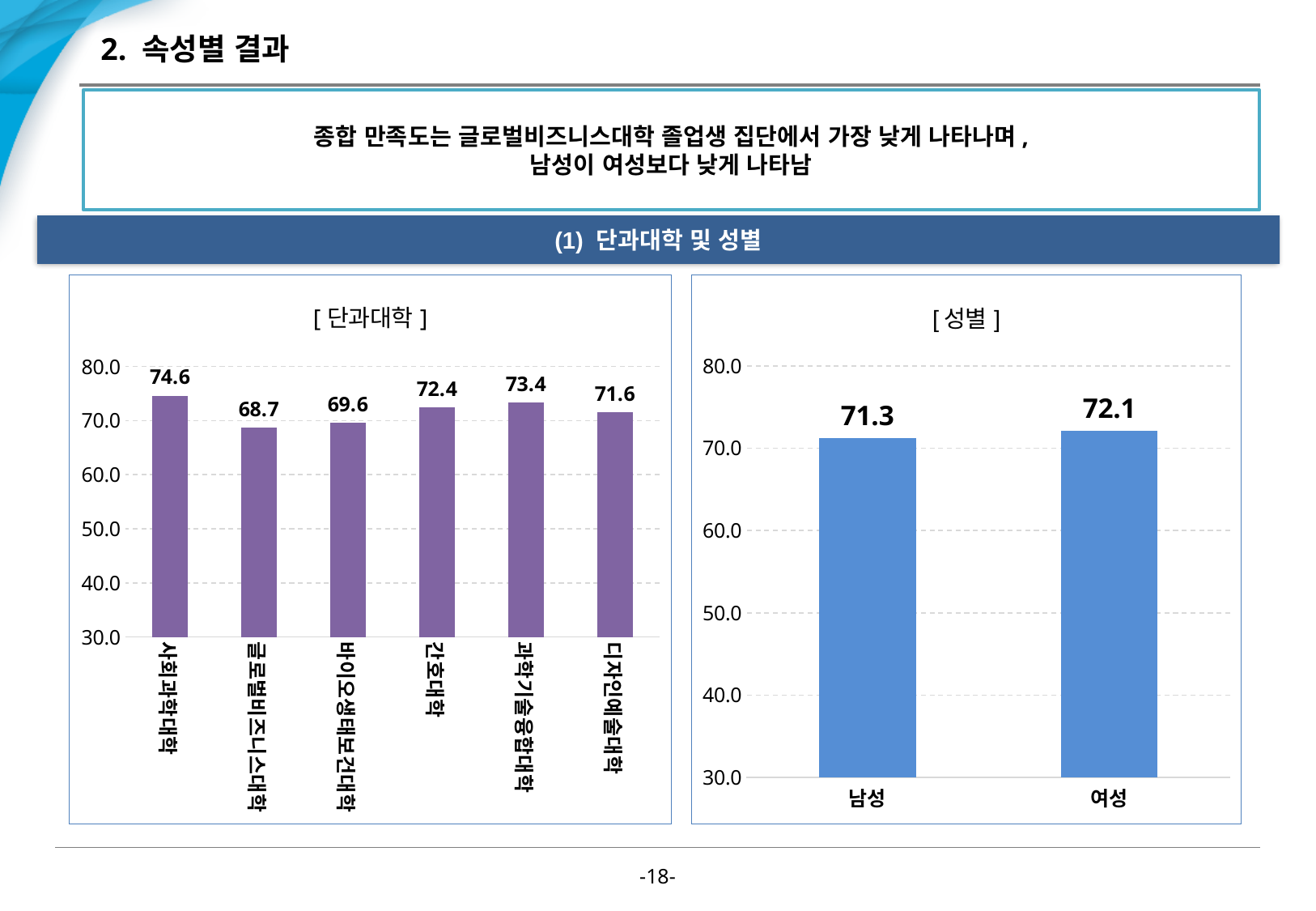
In the [ 단과대학 ] chart, what is the difference between the values for 사회과학대학 and 글로벌비즈니스대학? 5.9 In the [ 단과대학 ] chart, what is the value for 사회과학대학? 74.6 In the [ 단과대학 ] chart, what is the value for 과학기술융합대학? 73.4 In the [ 단과대학 ] chart, what is the value for 글로벌비즈니스대학? 68.7 In the [ 성별 ] chart, what is the value for 남성? 71.3 In the [ 단과대학 ] chart, which category has the highest value? 사회과학대학 What kind of chart is the [ 성별 ] chart? Bar chart In the [ 성별 ] chart, what is the difference between the values for 여성 and 남성? 0.8 How many categories are shown in the [ 단과대학 ] chart? 6 In the [ 단과대학 ] chart, which is larger, the value for 간호대학 or the value for 바이오생태보건대학? 간호대학 In the [ 성별 ] chart, what is the value for 여성? 72.1 In the [ 단과대학 ] chart, which category has the lowest value? 글로벌비즈니스대학